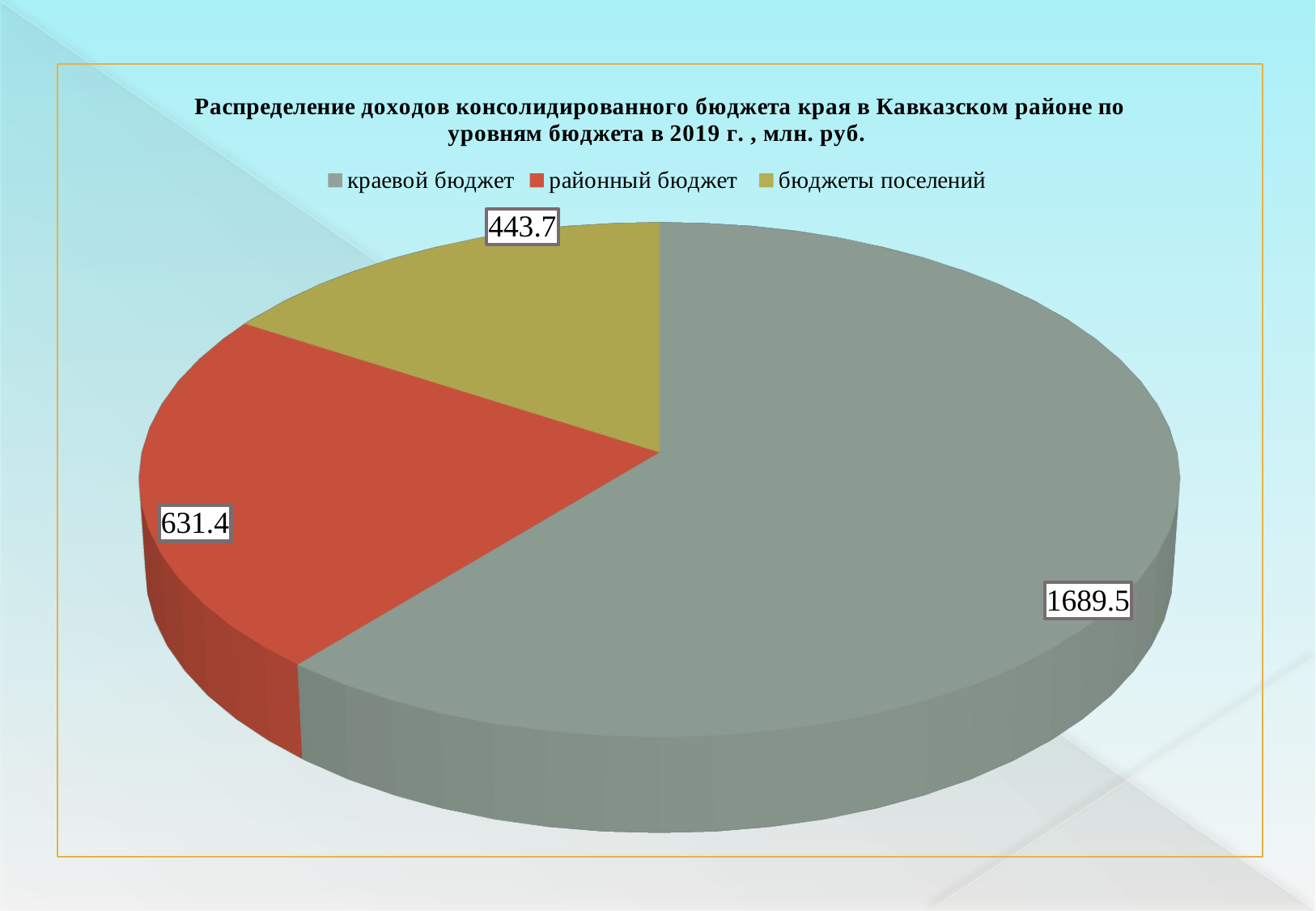
What is the value for краевой бюджет? 1689.5 Which budget level has the smallest slice? бюджеты поселений What colour is the slice for районный бюджет? red Which budget level has the largest slice? краевой бюджет What is the total of all three slices? 2764.6 What is the value for районный бюджет? 631.4 What is the difference between районный бюджет and бюджеты поселений? 187.7 How many slices does the pie chart have? 3 What is the value for бюджеты поселений? 443.7 Which is larger, районный бюджет or бюджеты поселений? районный бюджет What kind of chart is shown on the slide? pie chart What is the difference between краевой бюджет and районный бюджет? 1058.1